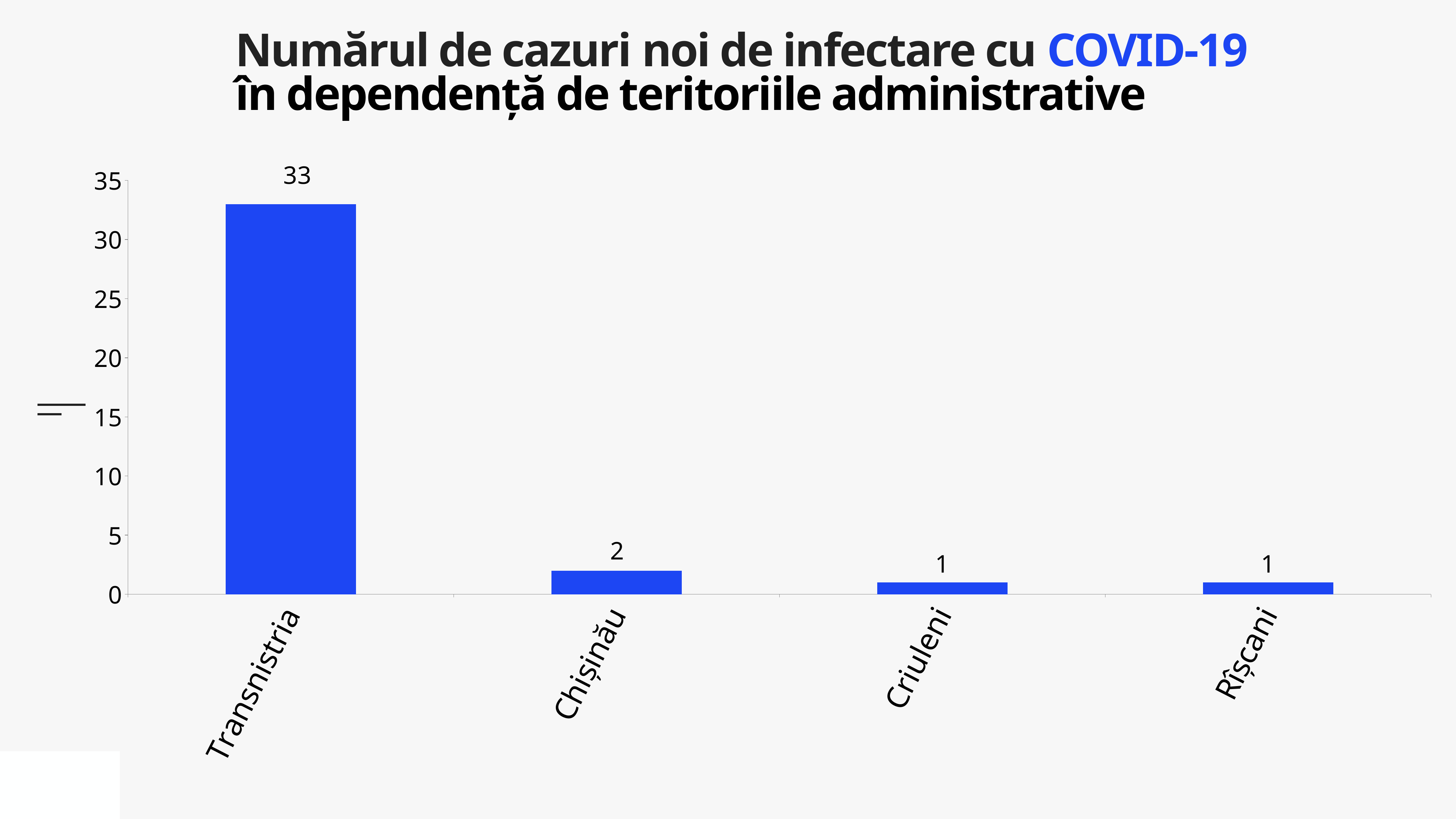
What is the number of new COVID-19 cases for Criuleni? 1 Which territory has the highest number of new cases? Transnistria What is the number of new COVID-19 cases for Transnistria? 33 Which has more new cases, Chișinău or Criuleni? Chișinău How many territories are shown on the chart? 4 What is the number of new COVID-19 cases for Chișinău? 2 What is the total number of new cases across all four territories shown? 37 What is the difference between the number of new cases in Chișinău and Criuleni? 1 What kind of chart is shown on the slide? Bar chart What is the difference between the number of new cases in Transnistria and Chișinău? 31 Is the value for Transnistria greater or less than 30? greater What is the number of new COVID-19 cases for Rîșcani? 1